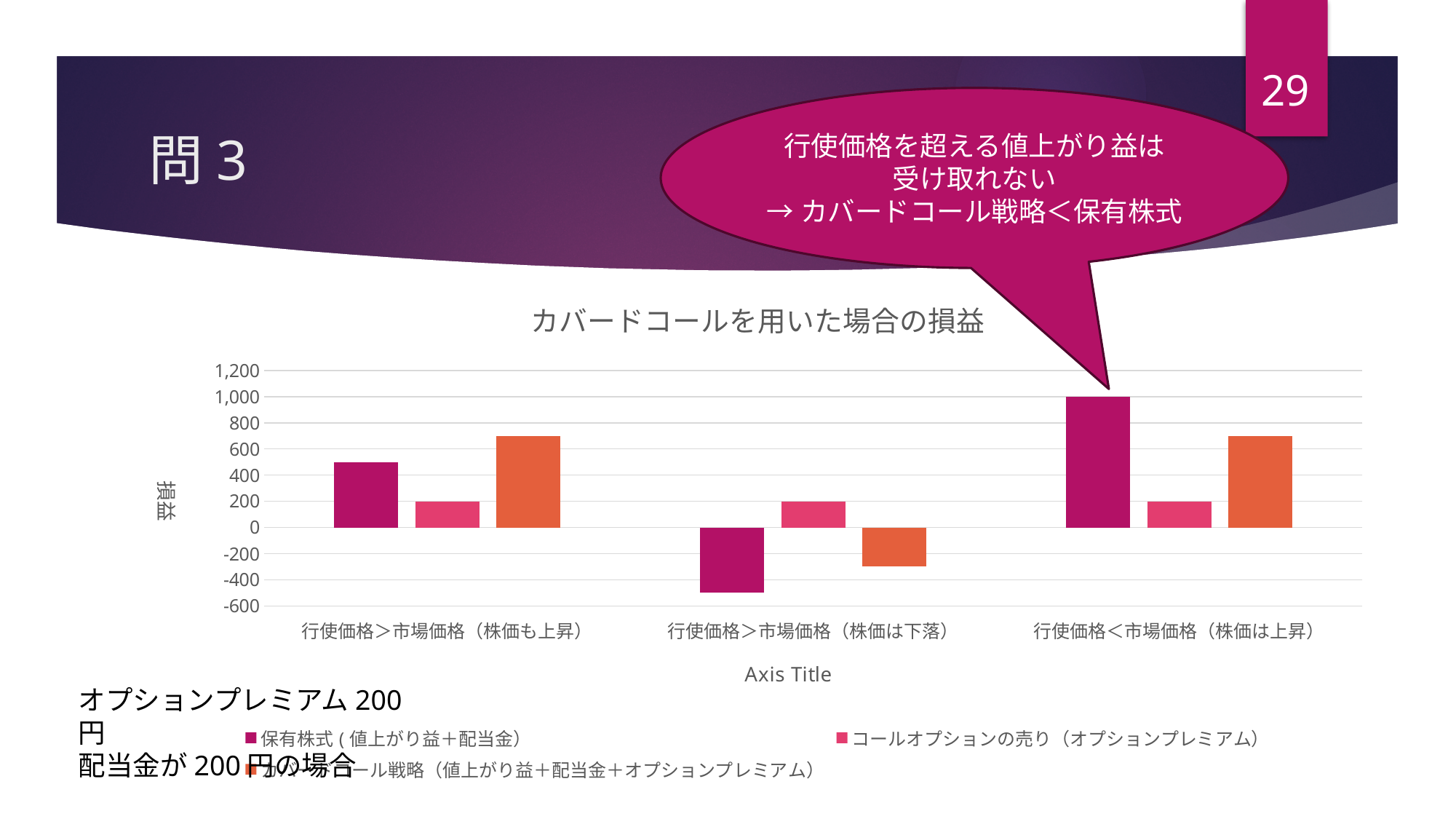
Is the value of カバードコール戦略 for 行使価格＞市場価格（株価も上昇） greater or less than 600? greater What kind of chart is shown on the slide? Bar chart For 行使価格＜市場価格（株価は上昇）, which is larger: 保有株式 or カバードコール戦略? 保有株式 Which category has the lowest 保有株式 value? 行使価格＞市場価格（株価は下落） How many series does the chart's legend list? 3 What is the value of 保有株式 for 行使価格＜市場価格（株価は上昇）? 1,000 What is the x-axis title shown on the chart? Axis Title How many categories are shown on the x axis of the chart? 3 Is the value of 保有株式 for 行使価格＞市場価格（株価は下落） greater or less than -400? less What is the value of コールオプションの売り（オプションプレミアム） for 行使価格＞市場価格（株価も上昇）? 200 What is the title of the chart? カバードコールを用いた場合の損益 Which category has the highest 保有株式 value? 行使価格＜市場価格（株価は上昇）